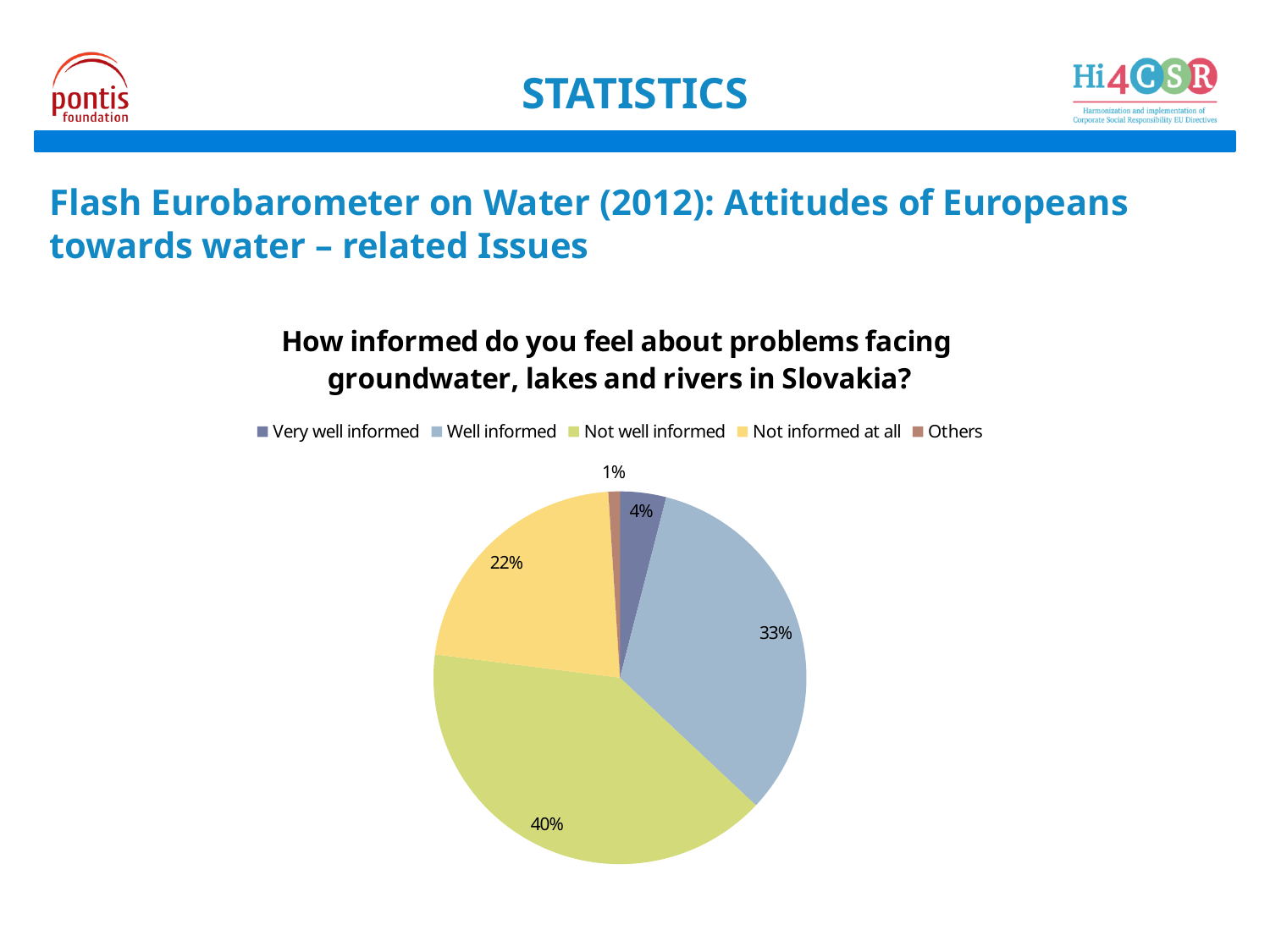
What is the difference in percentage points between 'Not well informed' and 'Well informed'? 7 Which is larger, the share for 'Not informed at all' or the share for 'Very well informed'? Not informed at all What kind of chart is shown on the slide? pie chart Which category has the largest share of the pie? Not well informed What share of the pie is labelled 'Others'? 1% What share of respondents said they are 'Very well informed'? 4% How many categories does the legend list? 5 What share of respondents said they are 'Not well informed'? 40% What share of respondents said they are 'Well informed'? 33% What share of respondents said they are 'Not informed at all'? 22% Which category has the smallest share of the pie? Others What is the title of the chart? How informed do you feel about problems facing groundwater, lakes and rivers in Slovakia?